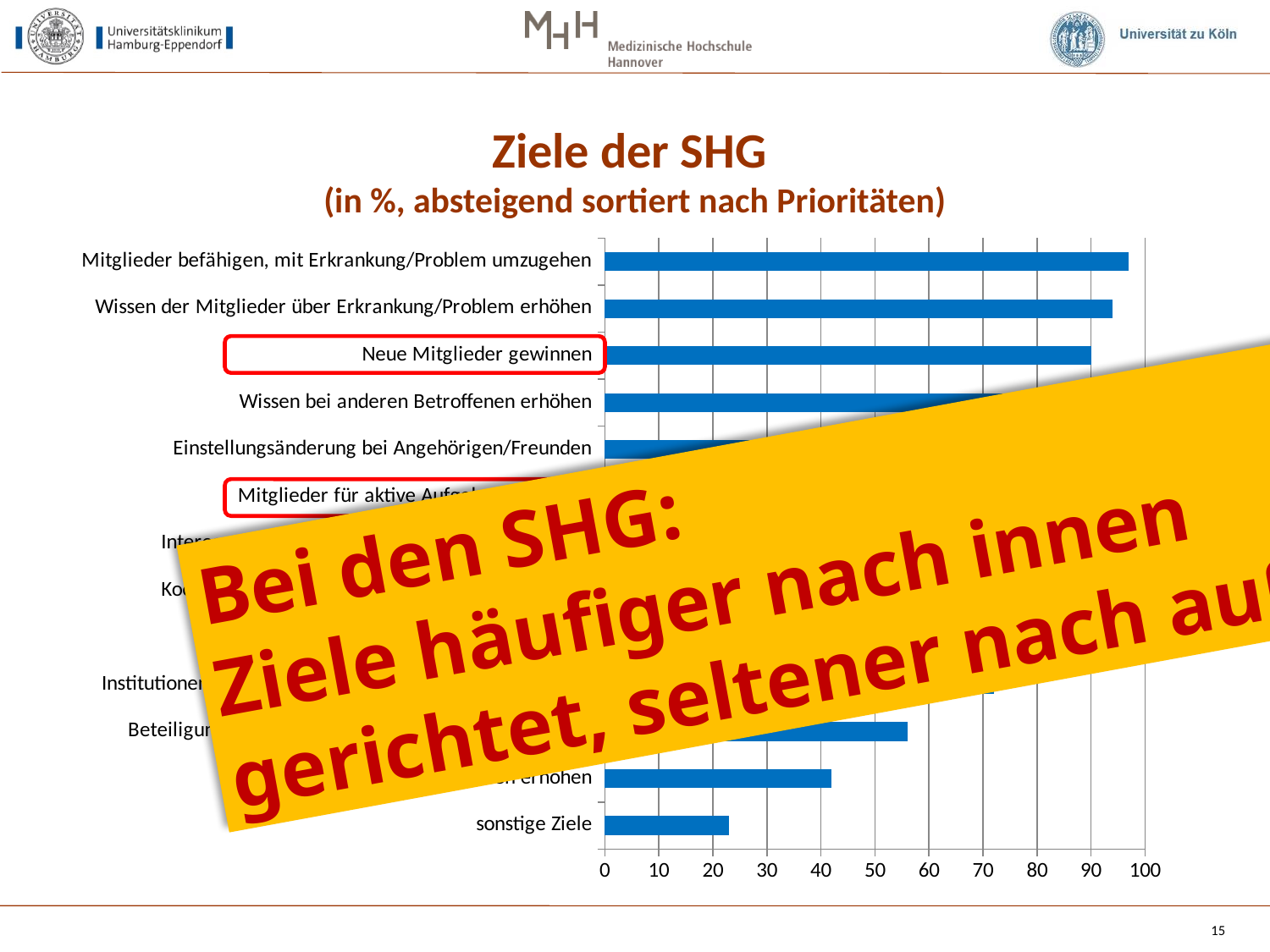
Is the value for "Mitglieder befähigen, mit Erkrankung/Problem umzugehen" greater or less than 90? greater What is the highest value shown on the x axis of the chart? 100 What is the title of the chart? Ziele der SHG What kind of chart is shown on the slide? bar chart Which category has the highest value in the chart? Mitglieder befähigen, mit Erkrankung/Problem umzugehen Is the value for "Neue Mitglieder gewinnen" greater or less than 70? greater Which has a larger value: "Neue Mitglieder gewinnen" or "sonstige Ziele"? Neue Mitglieder gewinnen Is the value for "Wissen der Mitglieder über Erkrankung/Problem erhöhen" greater or less than 80? greater Which has a larger value: "Mitglieder befähigen, mit Erkrankung/Problem umzugehen" or "sonstige Ziele"? Mitglieder befähigen, mit Erkrankung/Problem umzugehen Which category has the lowest value in the chart? sonstige Ziele